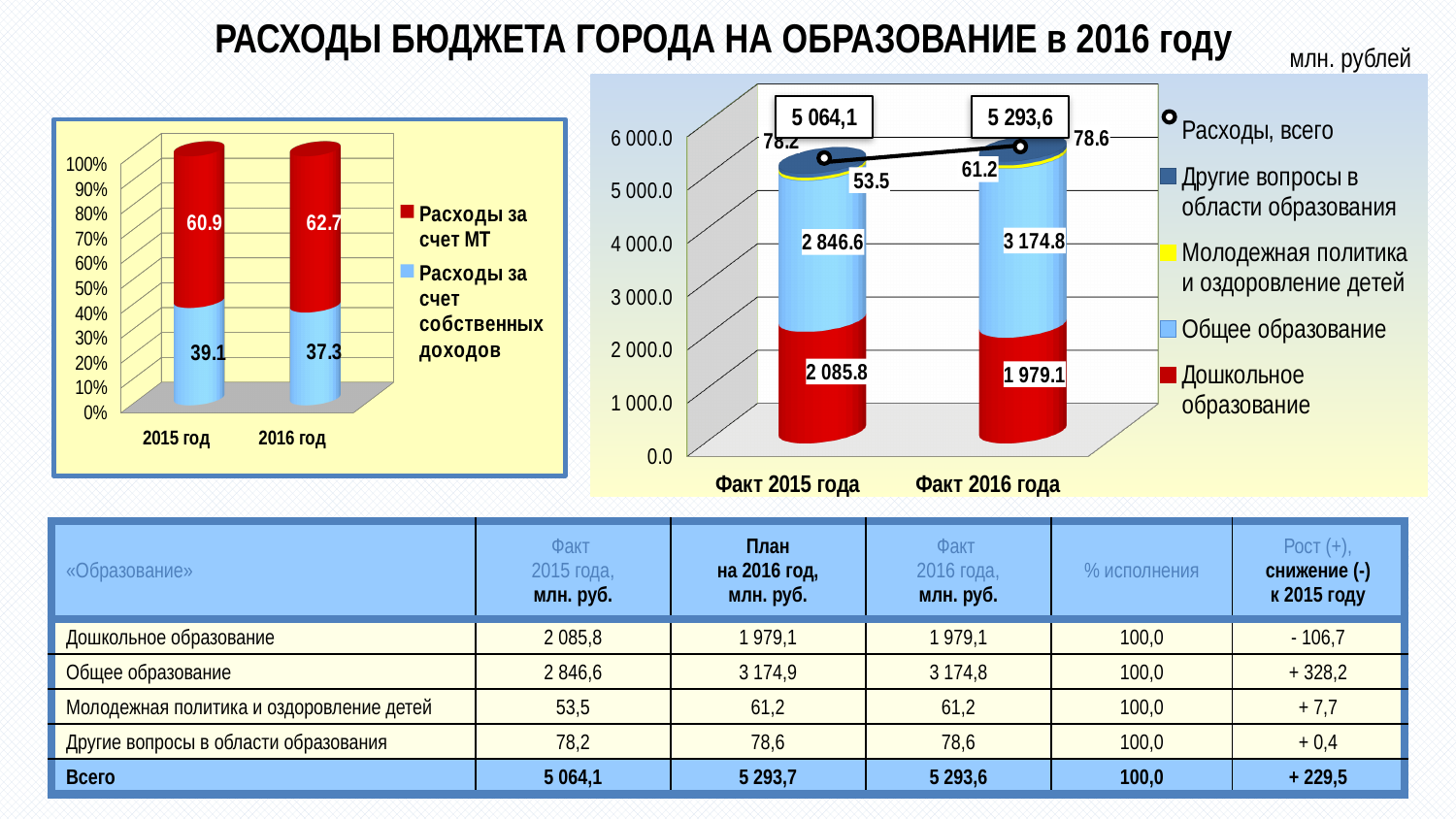
On the right chart, is the value for Дошкольное образование in Факт 2016 года greater or less than 2 000.0? less On the right chart, what is the value of Расходы, всего for Факт 2016 года? 5 293,6 On the right chart, what is the value for Общее образование in Факт 2016 года? 3 174.8 What kind of chart is the right chart? stacked bar chart with a line On the right chart, which series has the lowest value in Факт 2015 года? Молодежная политика и оздоровление детей On the right chart, what is the difference between Общее образование in Факт 2016 года and Факт 2015 года? 328.2 On the left chart, which year has the larger share of Расходы за счет МТ, 2015 год or 2016 год? 2016 год On the right chart, what is the value for Дошкольное образование in Факт 2015 года? 2 085.8 On the left chart, what is the value for Расходы за счет собственных доходов in 2016 год? 37.3 On the left chart, how many series does the legend list? 2 On the right chart, how many categories are shown on the x axis? 2 On the left chart, what is the value for Расходы за счет МТ in 2015 год? 60.9